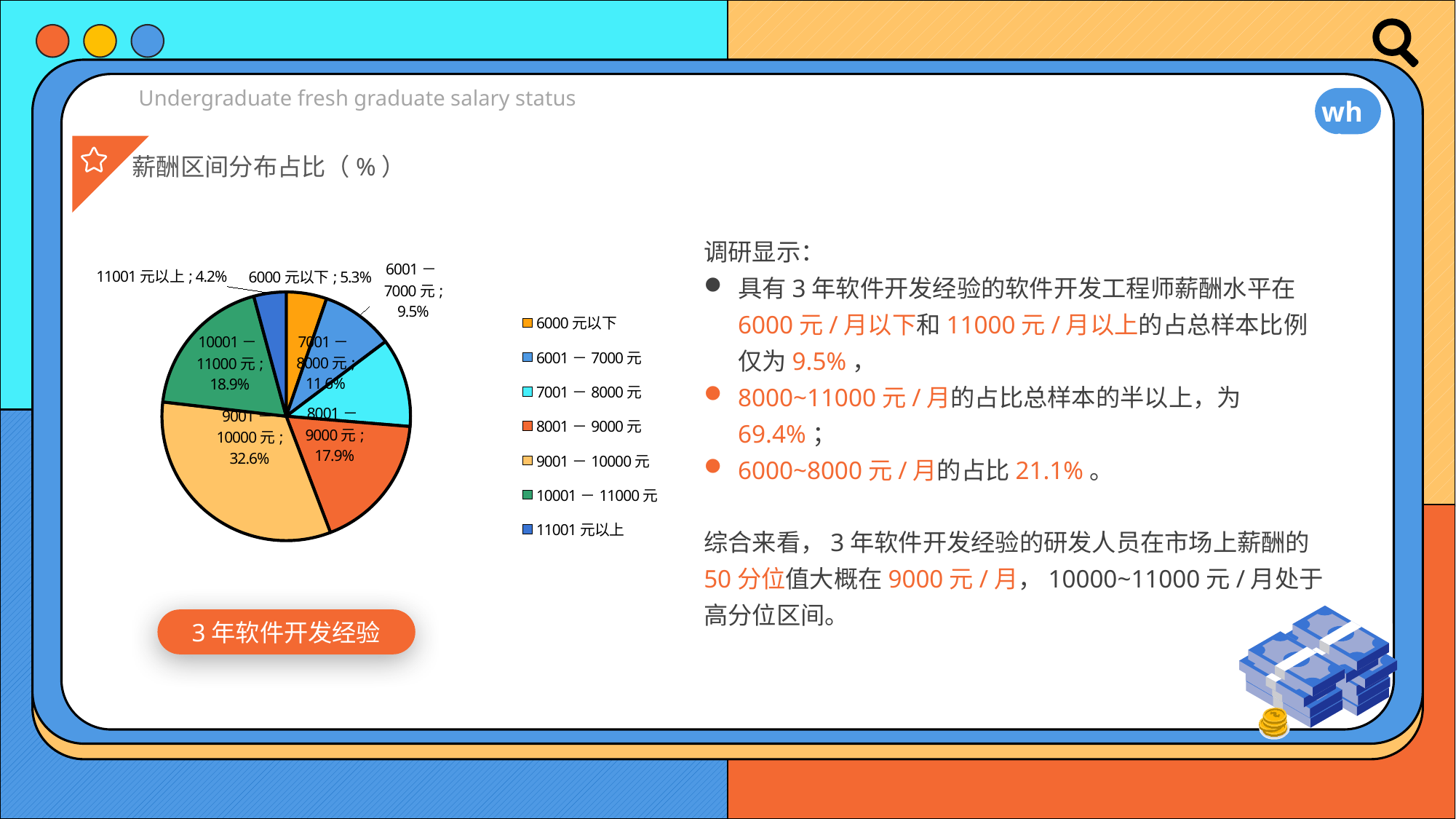
How many slices does the pie chart have? 7 What kind of chart is shown on the slide? pie chart What is the value shown for the 11001 元以上 slice? 4.2% What is the title of the chart section on the slide? 薪酬区间分布占比（%） What is the value shown for the 8001－9000 元 slice? 17.9% What is the value shown for the 6000 元以下 slice? 5.3% What is the difference between the shares of 9001－10000 元 and 10001－11000 元? 13.7% How many entries does the legend list? 7 Which salary range has the largest share of the pie? 9001－10000 元 Which slice is larger: 7001－8000 元 or 6001－7000 元? 7001－8000 元 What share of the pie does the 9001－10000 元 slice represent? 32.6% Which salary range has the smallest share of the pie? 11001 元以上